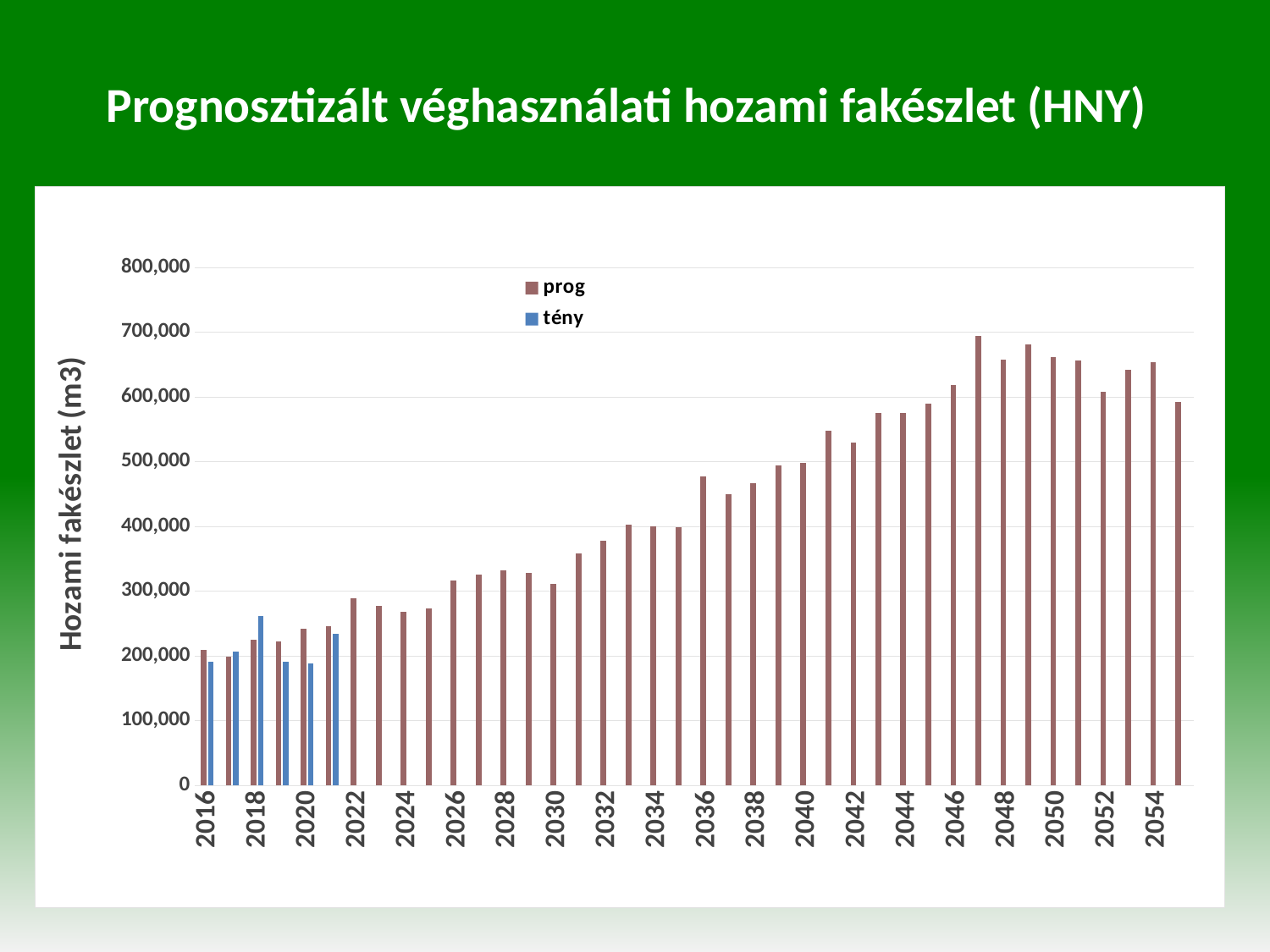
What are the two series named in the legend? prog and tény Which is larger: the prog value for 2047 or the prog value for 2055? 2047 Is the tény value for 2018 greater or less than 200,000? greater Which year has the highest prog value? 2047 For 2018, which is larger: the prog value or the tény value? tény What kind of chart is shown on the slide? bar chart How many years have a tény bar? 6 What is the y-axis label of the chart? Hozami fakészlet (m3) Is the prog value for 2036 greater or less than 500,000? less How many series does the legend list? 2 Is the prog value for 2047 greater or less than 600,000? greater